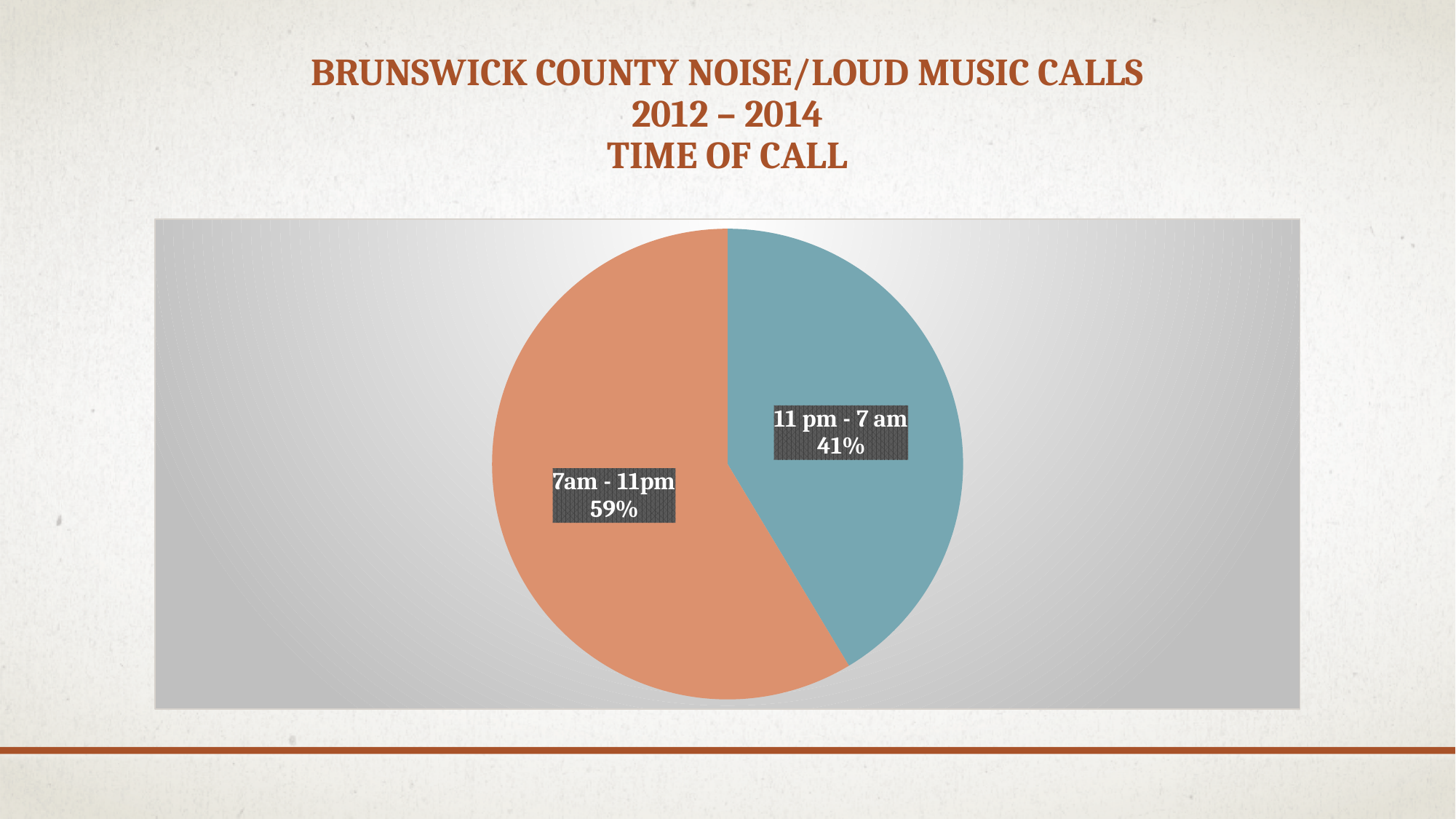
Which time period has the smallest share of calls? 11 pm - 7 am What is the difference in percentage points between the 7am - 11pm slice and the 11 pm - 7 am slice? 18 How many slices does the pie chart have? 2 What kind of chart is shown on the slide? pie chart What is the title of the chart? Brunswick County Noise/Loud Music Calls 2012 – 2014 Time of Call Which time period has the largest share of calls? 7am - 11pm Is the share for 11 pm - 7 am greater or less than 50%? less Which is larger, the share for 7am - 11pm or the share for 11 pm - 7 am? 7am - 11pm What share of calls occurred between 11 pm and 7 am? 41% What share of calls occurred between 7am and 11pm? 59% What colour is the 11 pm - 7 am slice? blue